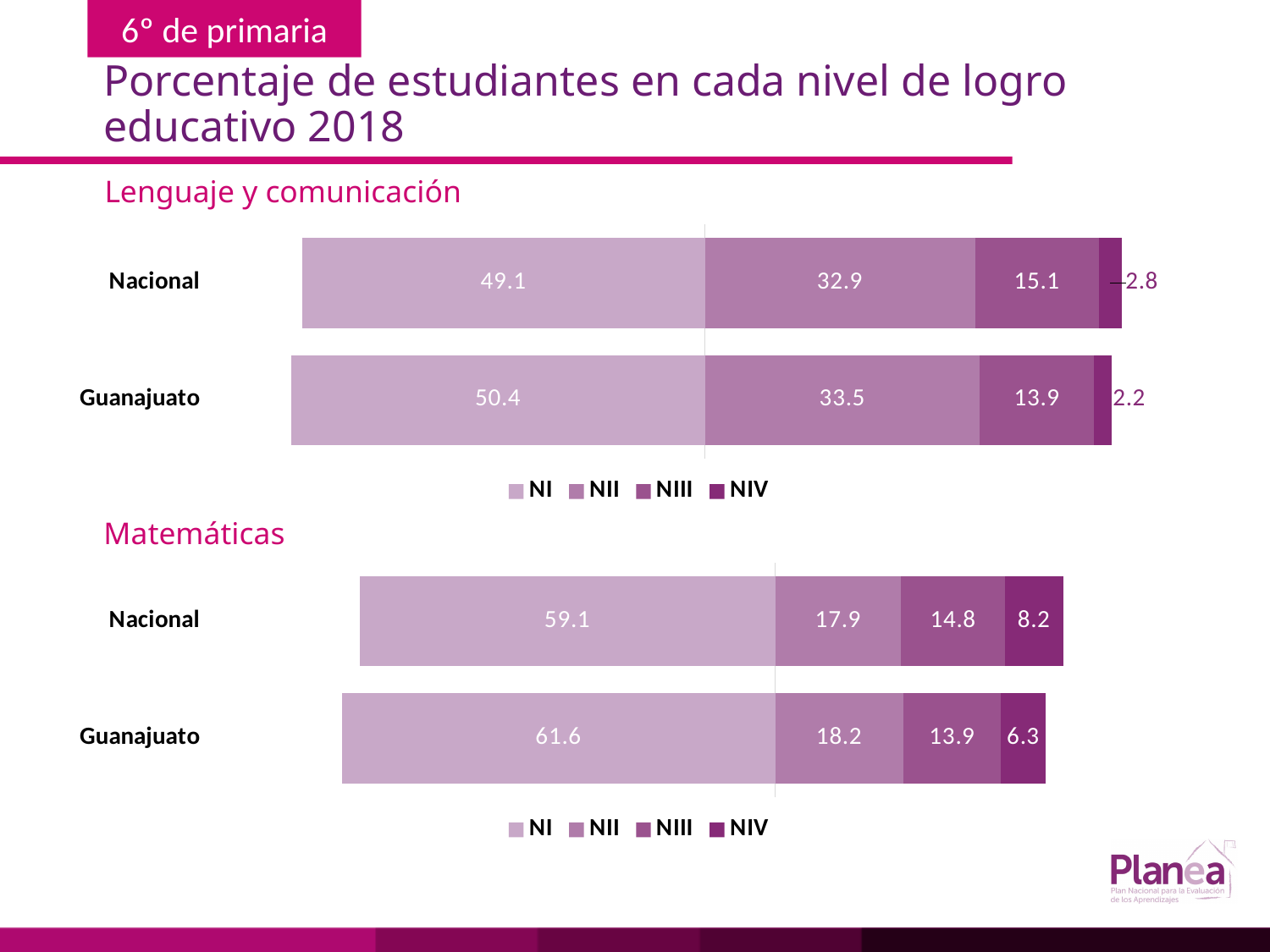
In the Matemáticas chart, what is the NIV value for Nacional? 8.2 In the Matemáticas chart, what is the difference between the NIV values for Nacional and Guanajuato? 1.9 In the Matemáticas chart, what is the NII value for Guanajuato? 18.2 What kind of chart is the Matemáticas chart? Stacked bar chart In the Lenguaje y comunicación chart, what is the NIV value for Guanajuato? 2.2 In the Matemáticas chart, what is the total of the stacked bar for Guanajuato? 100.0 In the Lenguaje y comunicación chart, which level has the lowest value for Nacional? NIV How many series does the legend of the Lenguaje y comunicación chart list? 4 In the Lenguaje y comunicación chart, what is the difference between the NI values for Guanajuato and Nacional? 1.3 In the Lenguaje y comunicación chart, what is the NI value for Nacional? 49.1 In the Matemáticas chart, which level has the highest value for Guanajuato? NI In the Matemáticas chart, is the NIII value larger for Nacional or for Guanajuato? Nacional